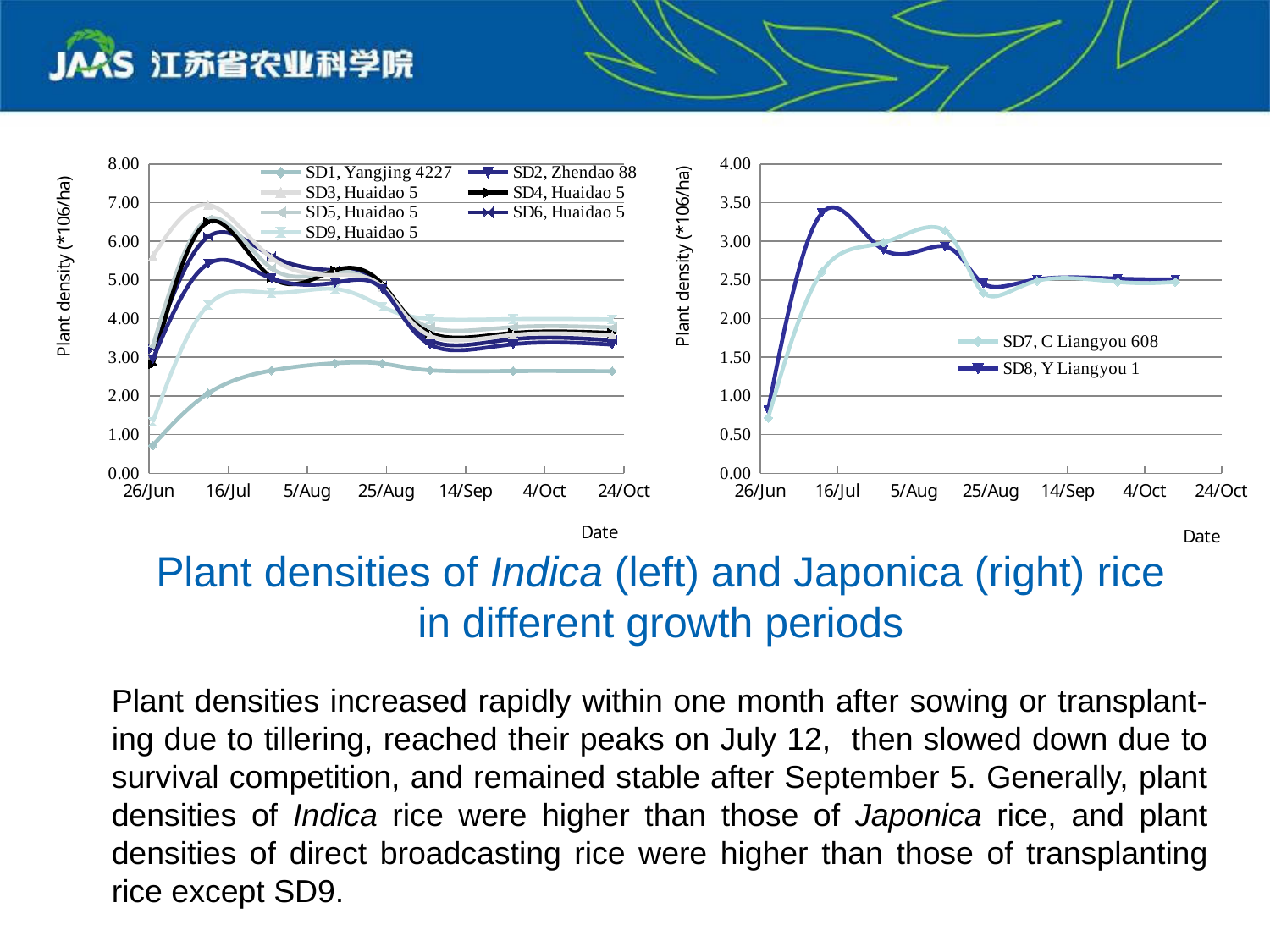
In the left chart, which series has the lowest value at 24/Oct? SD1, Yangjing 4227 In the right chart, at 16/Jul, which is larger: SD7, C Liangyou 608 or SD8, Y Liangyou 1? SD8, Y Liangyou 1 In the left chart, is the value for SD1, Yangjing 4227 at 24/Oct greater or less than 3.00? less In the right chart, is the peak value for SD8, Y Liangyou 1 greater or less than 3.00? greater What kind of chart is the left chart on the slide? line chart How many series does the legend of the left chart list? 7 In the right chart, which two series are listed in the legend? SD7, C Liangyou 608 and SD8, Y Liangyou 1 In the right chart, is the value for SD7, C Liangyou 608 at 26/Jun greater or less than 1.00? less How many series does the legend of the right chart list? 2 What is the y-axis title of the left chart? Plant density (*106/ha) In the right chart, does the value for SD7, C Liangyou 608 rise or fall from 26/Jun to 16/Jul? rise